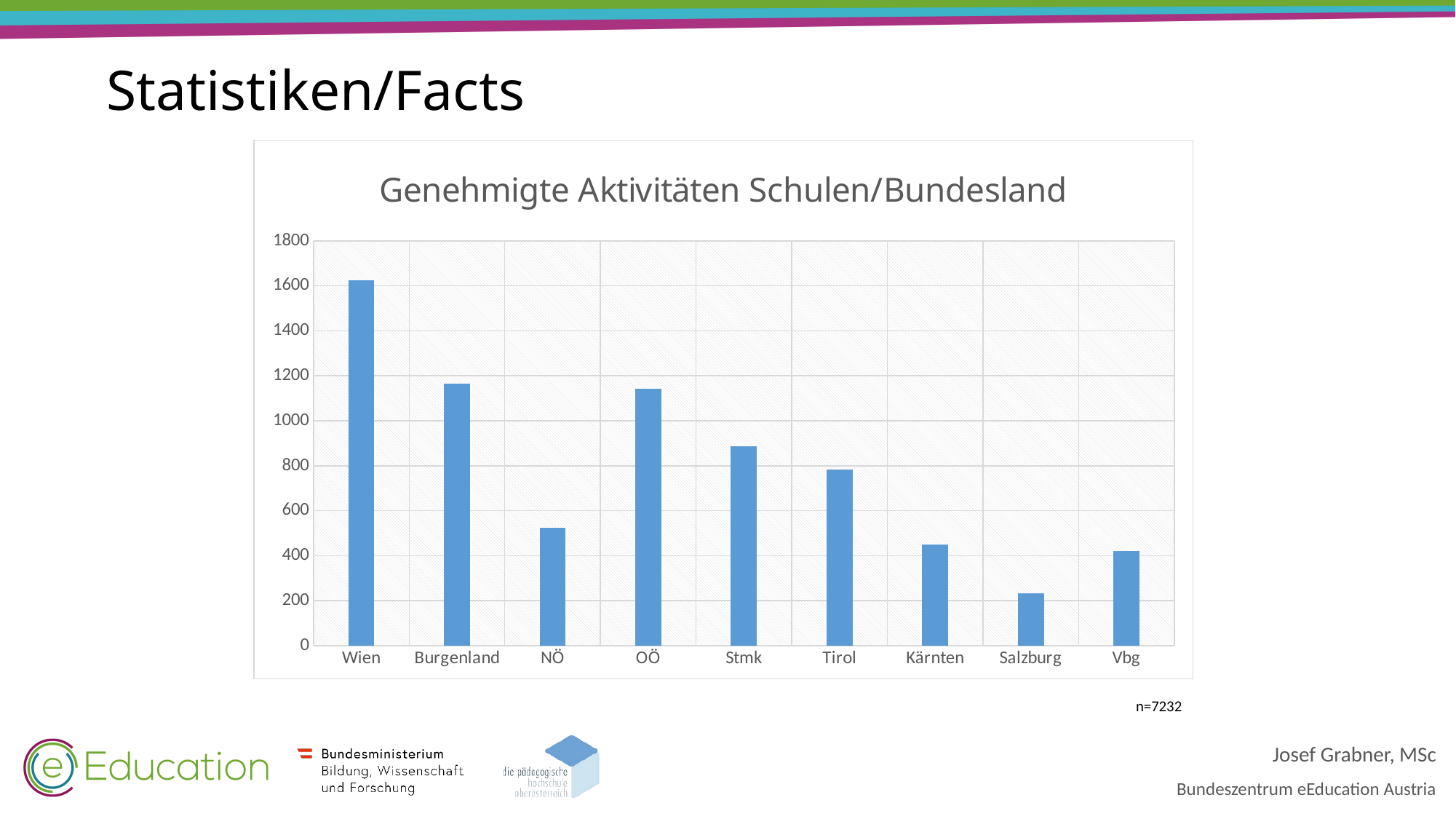
How many Bundesländer (categories) are shown on the x axis of the chart? 9 What kind of chart is shown on the slide? bar chart Which Bundesland has the highest number of genehmigte Aktivitäten? Wien Which has a higher value, NÖ or Vbg? NÖ Which has a higher value, Stmk or Tirol? Stmk Is the value for Wien greater or less than 1600? greater Is the value for Stmk greater or less than 800? greater Is the value for NÖ greater or less than 600? less What is the title of the chart? Genehmigte Aktivitäten Schulen/Bundesland Which Bundesland has the lowest number of genehmigte Aktivitäten? Salzburg